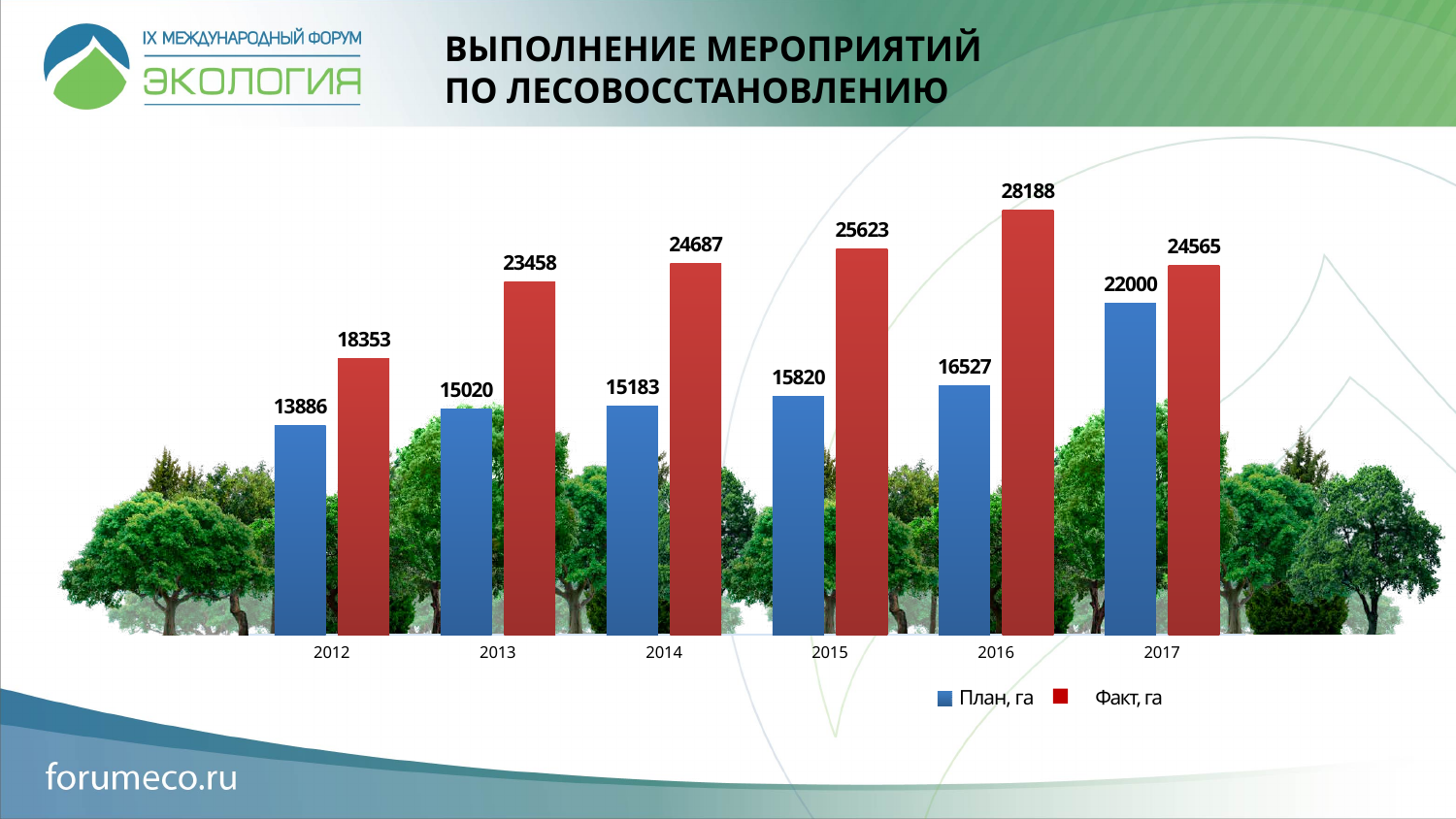
What is the value of "Факт, га" for 2016? 28188 What is the value of "План, га" for 2012? 13886 What is the difference between "Факт, га" and "План, га" in 2015? 9803 Does the "План, га" value rise or fall from 2012 to 2017? Rise How many series does the legend list? 2 What kind of chart is shown on the slide? Bar chart What is the value of "План, га" for 2017? 22000 How many years are shown on the x axis? 6 Which is larger: "Факт, га" in 2013 or "Факт, га" in 2014? Факт, га in 2014 In which year is the "Факт, га" value highest? 2016 What is the difference between "Факт, га" and "План, га" in 2017? 2565 In which year is the "План, га" value lowest? 2012